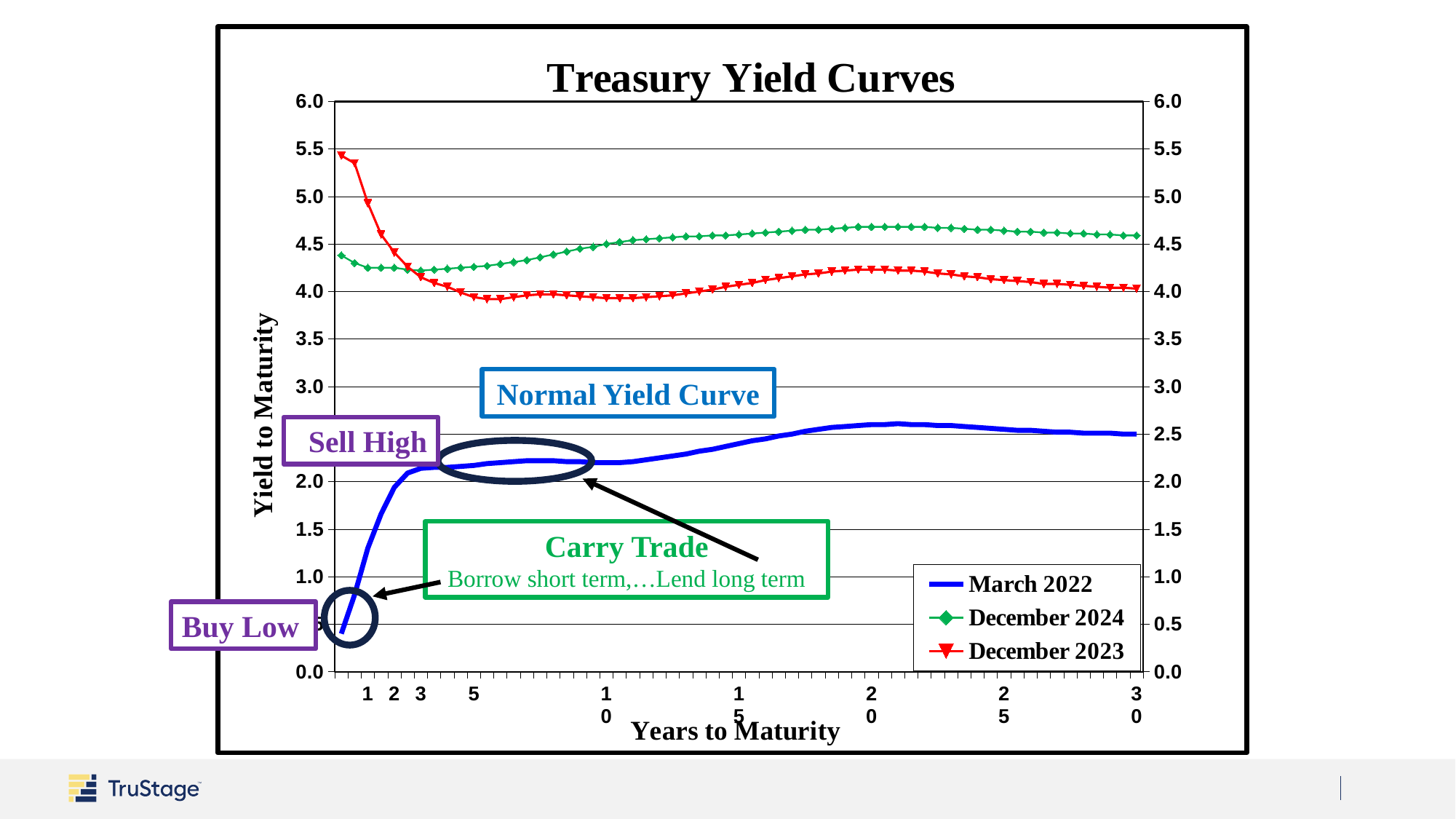
Is the December 2023 value at 30 years to maturity greater or less than 4.5? less At 30 years to maturity, which series is higher: December 2024 or December 2023? December 2024 Does the December 2023 curve rise or fall between the shortest maturity and 5 years? fall At 1 year to maturity, which series is higher: December 2023 or December 2024? December 2023 What is the title of the chart? Treasury Yield Curves What kind of chart is shown on the slide? line chart Is the March 2022 value at 10 years to maturity greater or less than 2.5? less How many series does the legend list? 3 What is the label of the vertical axis? Yield to Maturity Is the March 2022 value at 30 years to maturity greater or less than 3.0? less Does the March 2022 curve rise or fall between the shortest maturity and 5 years? rise